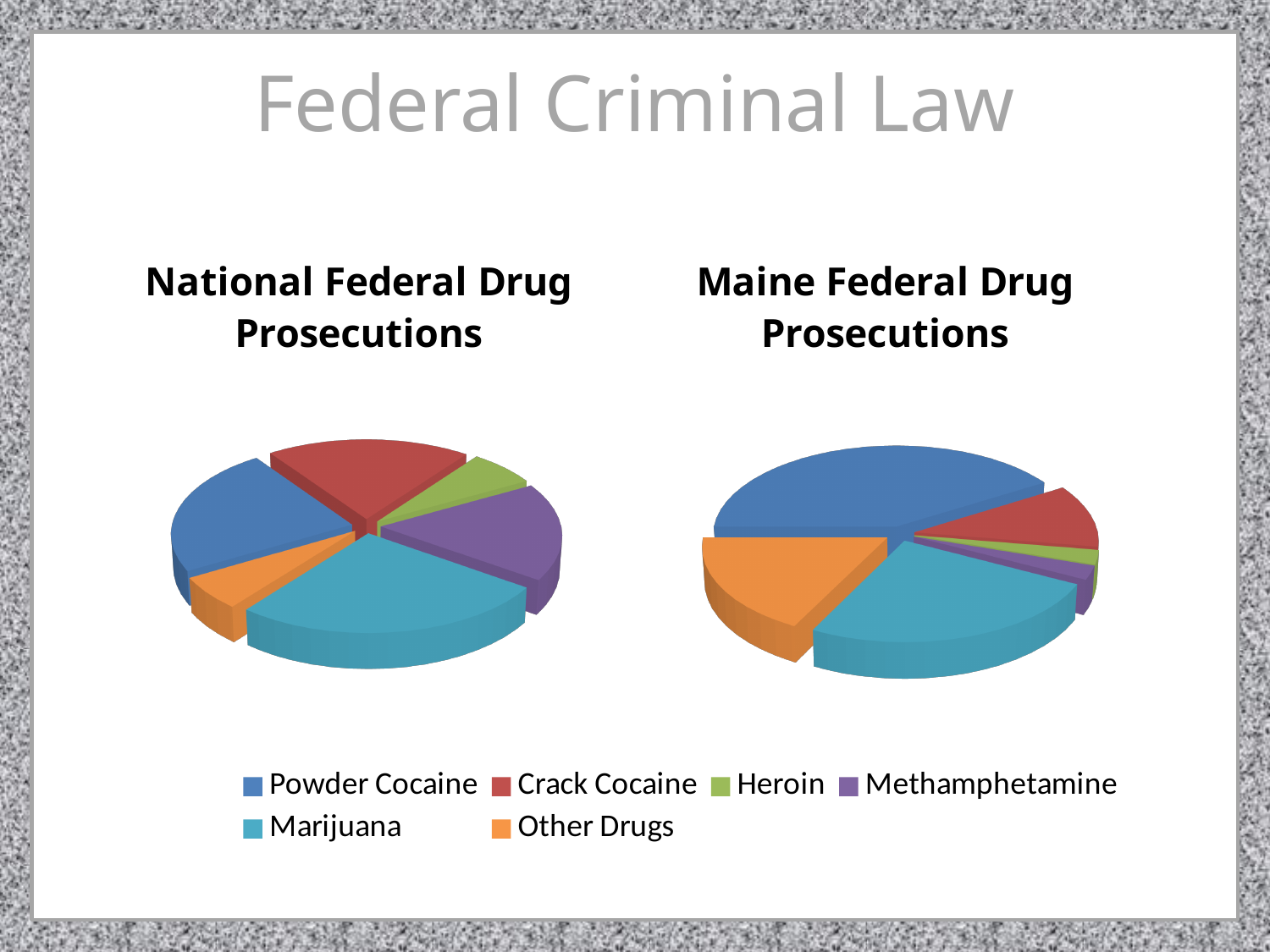
How many slices does the Maine Federal Drug Prosecutions pie chart have? 6 How many categories does the legend list for the charts? 6 What kind of chart is the Maine Federal Drug Prosecutions chart? pie chart In the National Federal Drug Prosecutions chart, which category has the largest slice? Marijuana In the National Federal Drug Prosecutions chart, which slice is larger: Crack Cocaine or Heroin? Crack Cocaine What is the title of the pie chart on the right side of the slide? Maine Federal Drug Prosecutions What colour represents Methamphetamine in the legend? purple In the National Federal Drug Prosecutions chart, which slice is larger: Marijuana or Heroin? Marijuana In the Maine Federal Drug Prosecutions chart, which slice is larger: Powder Cocaine or Crack Cocaine? Powder Cocaine What kind of chart is the National Federal Drug Prosecutions chart? pie chart In the Maine Federal Drug Prosecutions chart, which category has the largest slice? Powder Cocaine